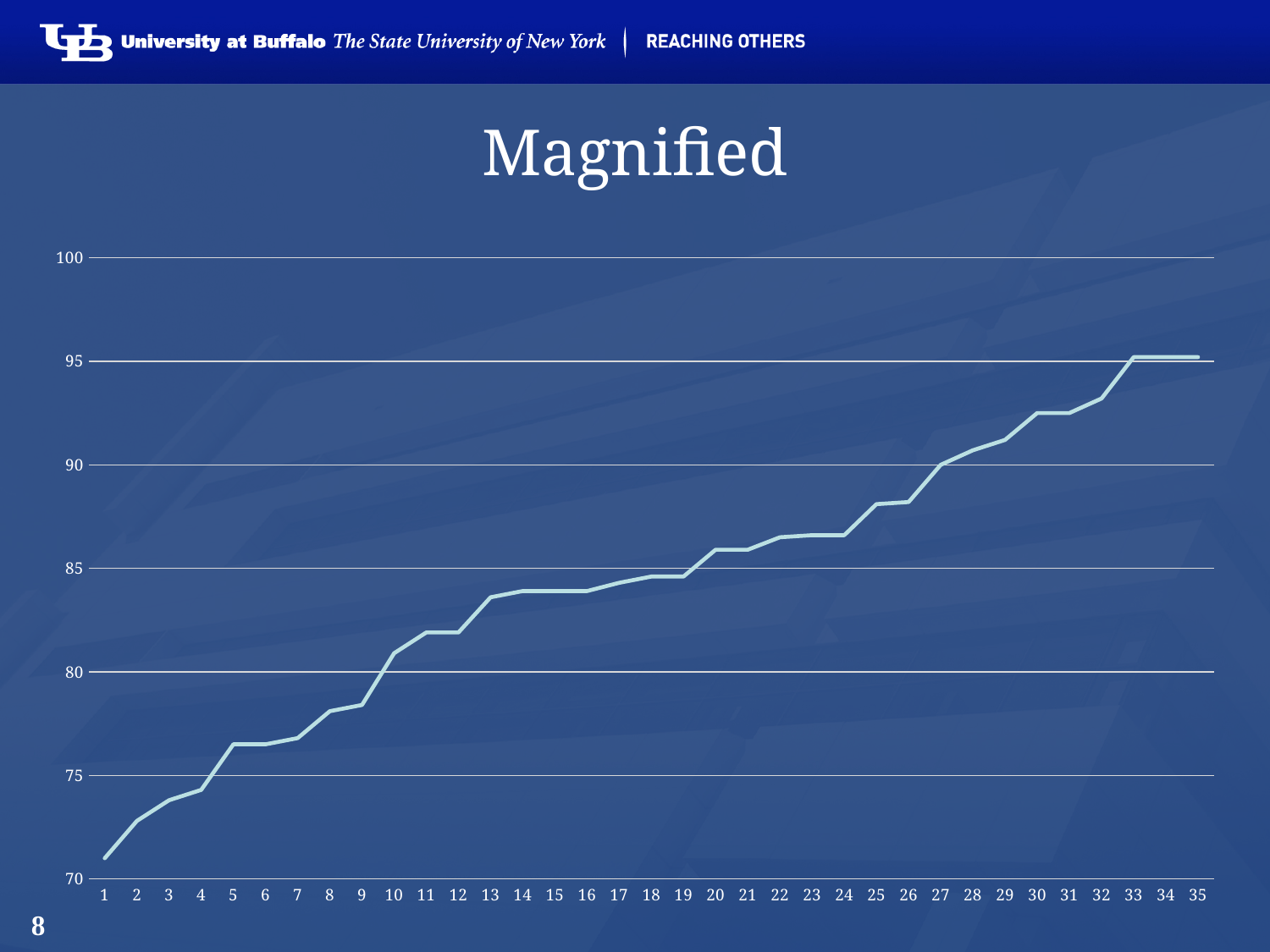
What is the title of the chart? Magnified Which has the larger value, point 3 or point 30? 30 How many points are plotted along the x axis? 35 Is the value at point 10 greater or less than 80? greater Is the value at point 1 greater or less than 75? less Which x-axis point has the lowest value? 1 What kind of chart is shown on the slide? line chart Do the values generally rise or fall as the x axis goes from 1 to 35? rise Is the value at point 9 greater or less than 80? less